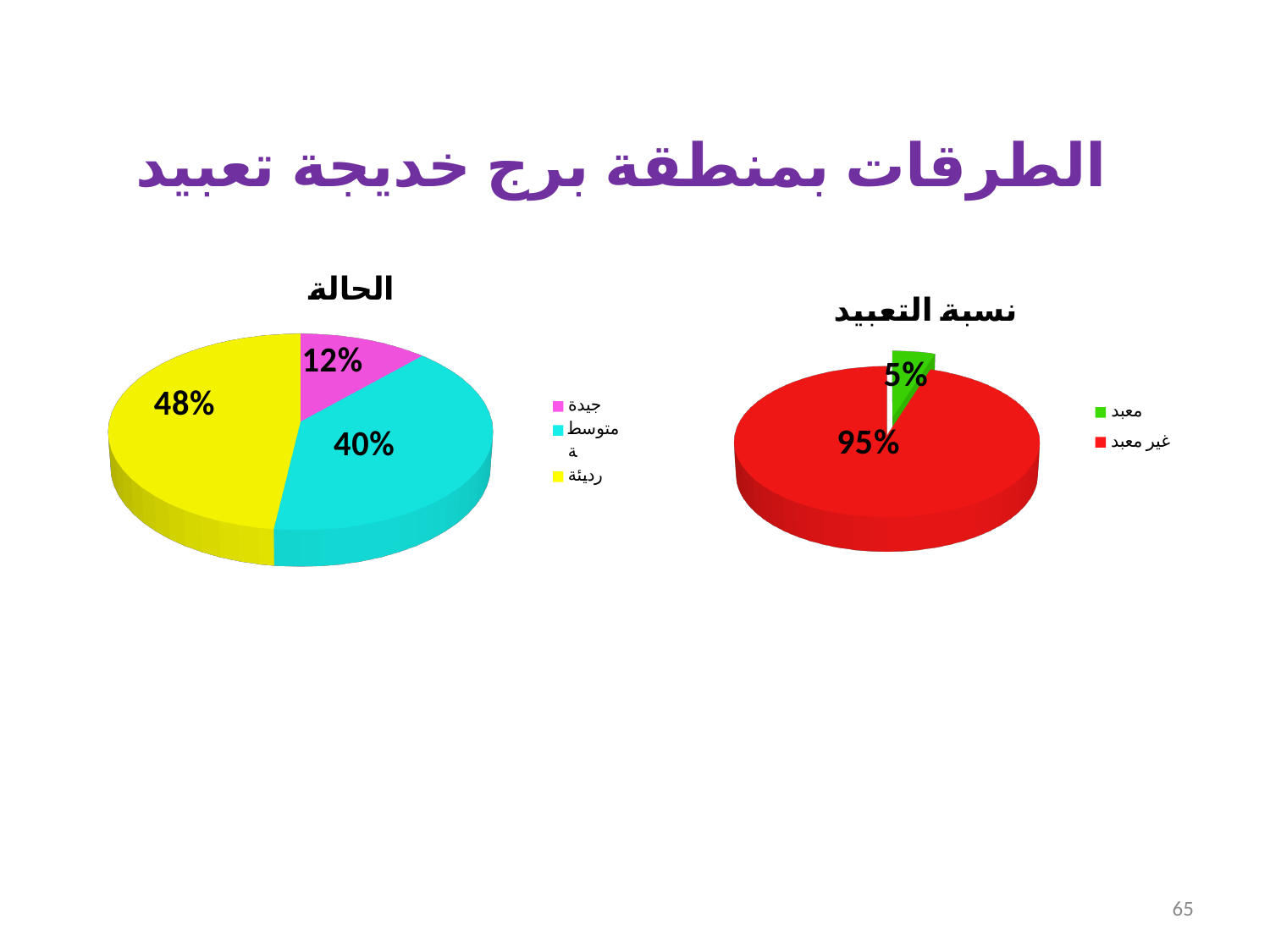
In the chart titled "الحالة", what is the difference between the "رديئة" and "متوسطة" slices? 8% In the chart titled "الحالة", what share of the pie is labelled "رديئة"? 48% In the chart titled "نسبة التعبيد", what colour is the "معبد" slice? Green In the chart titled "الحالة", what is the value shown for "جيدة"? 12% In the chart titled "الحالة", how many slices does the pie have? 3 In the chart titled "نسبة التعبيد", which is larger, "معبد" or "غير معبد"? غير معبد In the chart titled "الحالة", what is the value shown for "متوسطة"? 40% What type of chart is the chart titled "نسبة التعبيد"? Pie chart In the chart titled "نسبة التعبيد", what share of the pie is labelled "غير معبد"? 95% In the chart titled "الحالة", which category has the smallest slice? جيدة In the chart titled "الحالة", which category has the largest slice? رديئة In the chart titled "نسبة التعبيد", what is the value shown for "معبد"? 5%